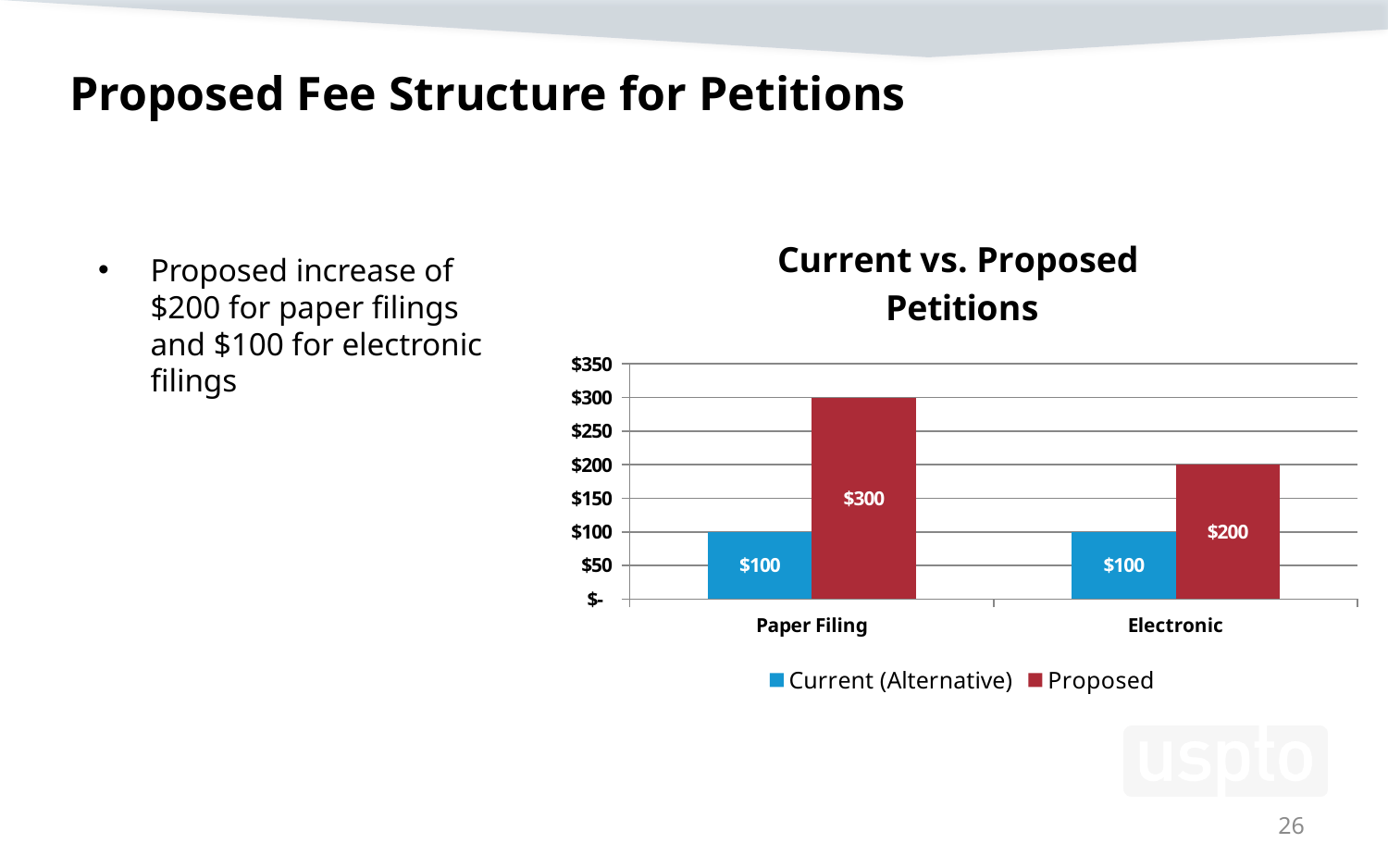
What is the difference between the Proposed fees for Paper Filing and Electronic? $100 What is the title of the chart? Current vs. Proposed Petitions What is the difference between the Proposed and Current (Alternative) fees for Paper Filing? $200 How many categories are shown on the x axis? 2 What is the Proposed fee for Electronic filing? $200 How many series does the legend list? 2 What is the Proposed fee for Paper Filing? $300 What kind of chart is shown on the slide? Bar chart Which is larger, the Proposed fee for Electronic or the Current (Alternative) fee for Paper Filing? Proposed fee for Electronic Which category has the highest Proposed fee? Paper Filing Is the Proposed fee for Paper Filing greater or less than $250? greater What is the Current (Alternative) fee for Electronic filing? $100